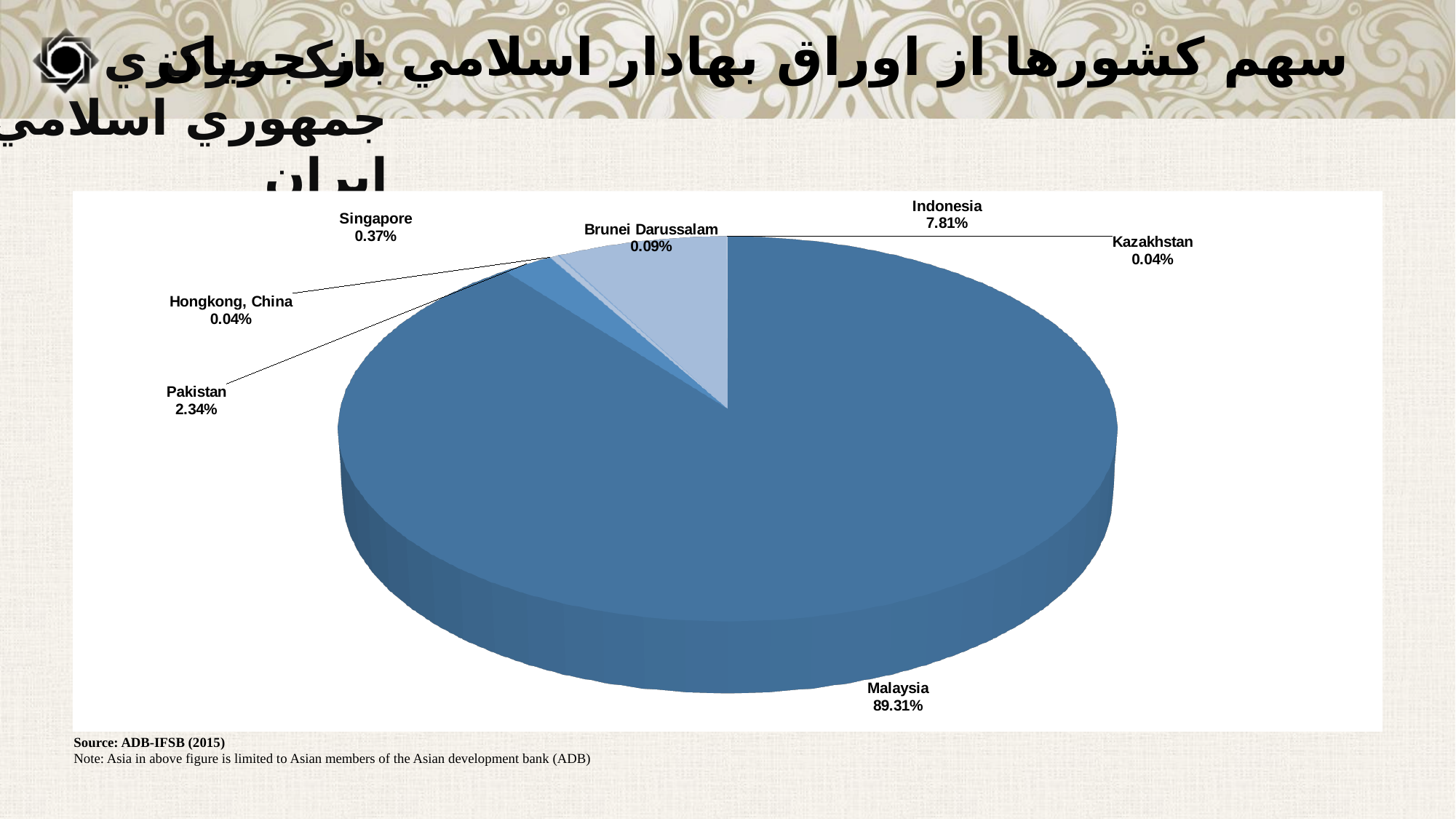
What is the value shown for Indonesia? 7.81% What is the difference between the shares of Indonesia and Pakistan? 5.47% What is the value shown for Brunei Darussalam? 0.09% How many countries are shown as slices in the pie chart? 7 Which country has the largest slice of the pie? Malaysia What kind of chart is shown on the slide? Pie chart What is the difference between the shares of Malaysia and Indonesia? 81.50% What is the value shown for Singapore? 0.37% What source is cited below the chart? ADB-IFSB (2015) What is the value shown for Pakistan? 2.34% What share of the pie does Malaysia hold? 89.31% Which is larger, the share for Pakistan or the share for Singapore? Pakistan